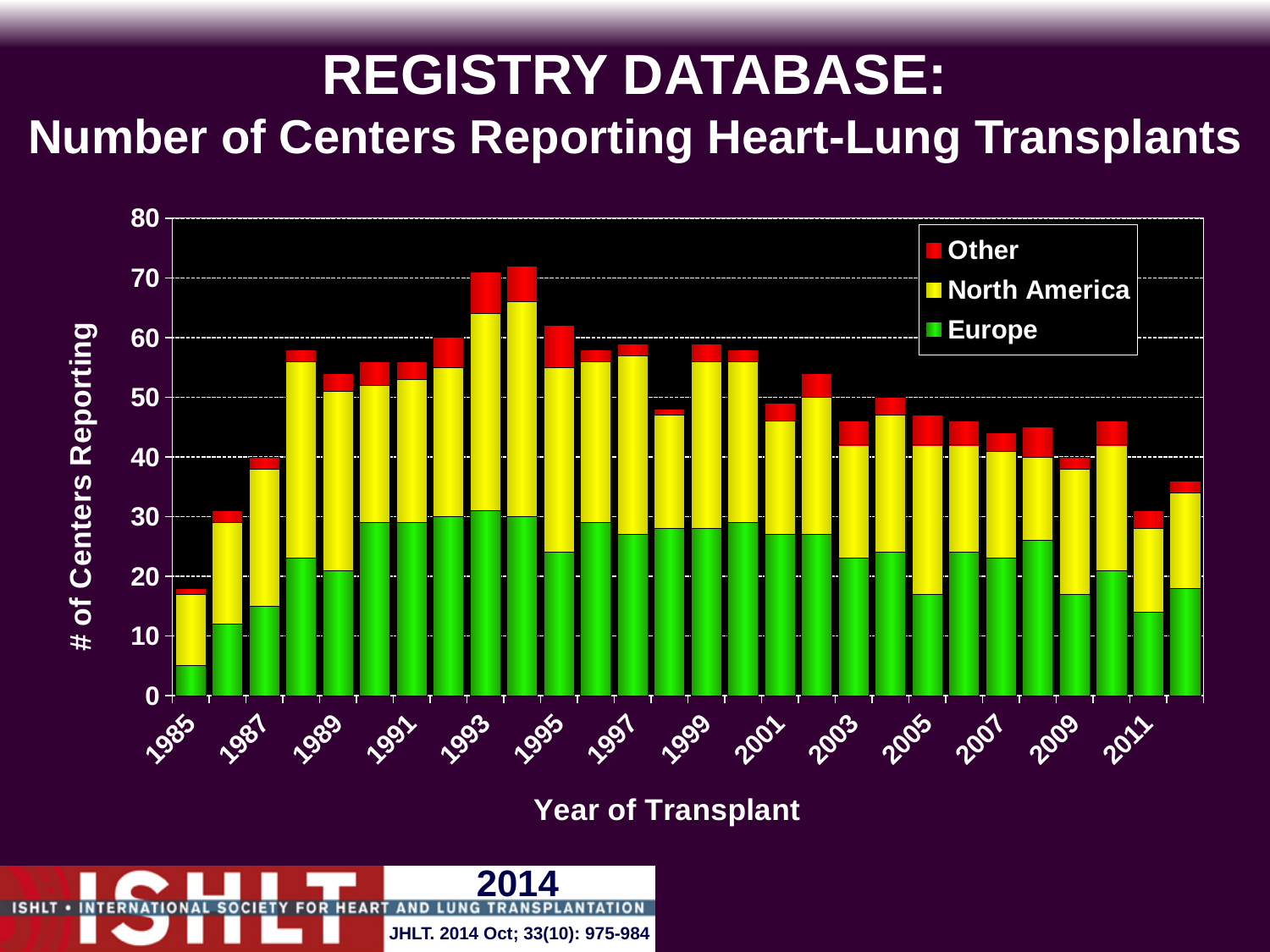
Is the total number of centers reporting in 1994 greater or less than 70? greater Does the total number of centers reporting generally rise or fall from 1994 to 2011? fall What kind of chart is shown on the slide? Stacked bar chart Which year has the larger total number of centers reporting, 1989 or 2005? 1989 Is the total number of centers reporting in 2012 greater or less than 40? less Is the number of Europe centers reporting in 1985 greater or less than 10? less How many series does the legend list? 3 Which series are listed in the legend? Other, North America, Europe Which year has the lowest total number of centers reporting? 1985 How many years (bars) are plotted in the chart? 28 What is the title of the x axis? Year of Transplant